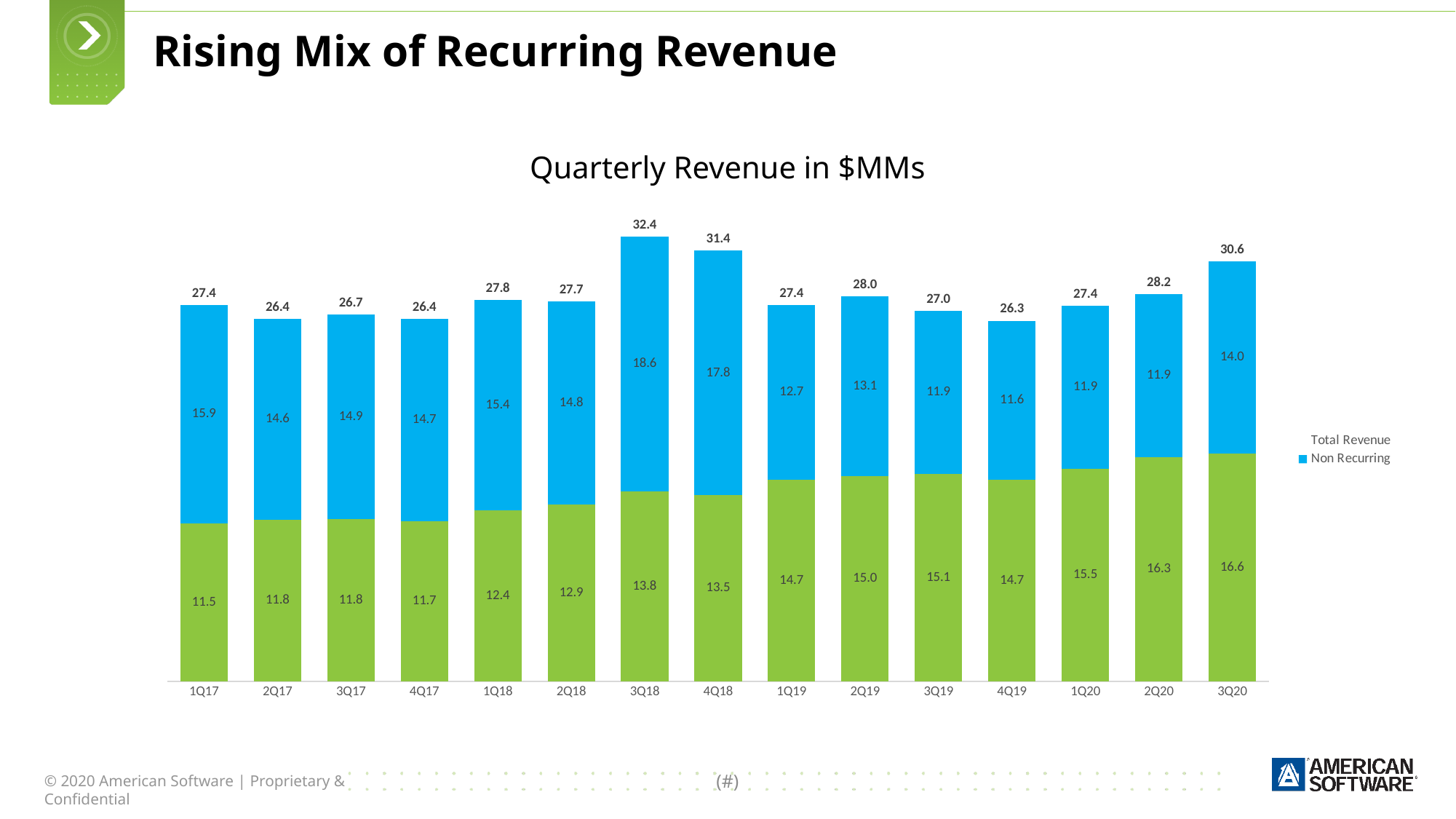
Which quarter has the highest total revenue? 3Q18 What kind of chart is shown on the slide? Stacked bar chart What is the difference between the total revenue for 3Q18 and 4Q18? 1.0 What is the value of the green (bottom) segment for 1Q17? 11.5 How many quarters are shown on the x axis? 15 How many entries does the legend list? 2 Does the green (bottom) segment generally rise or fall from 1Q17 to 3Q20? Rise Which quarter has the lowest total revenue? 4Q19 What is the Non Recurring value for 3Q18? 18.6 What is the title of the chart? Quarterly Revenue in $MMs What is the total revenue shown above the bar for 3Q20? 30.6 Which is larger, the Non Recurring value for 1Q17 or for 3Q20? 1Q17